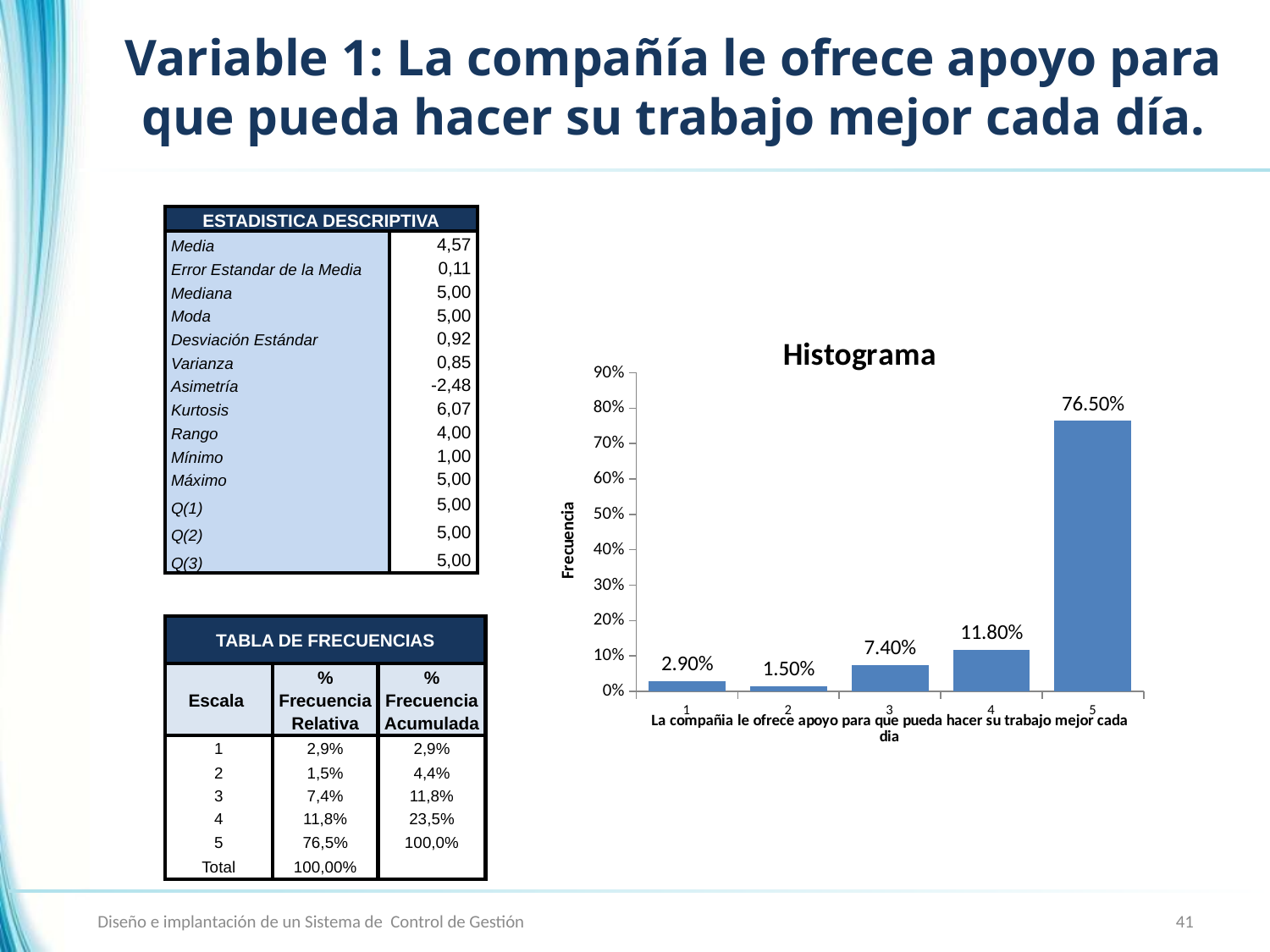
Is the value for category 5 in the Histograma chart greater or less than 70%? greater What is the difference between the values for category 4 and category 3 in the Histograma chart? 4.40% What is the value for category 5 in the Histograma chart? 76.50% Do the values in the Histograma chart rise or fall from category 2 to category 5? rise Which category has the highest value in the Histograma chart? 5 What is the y-axis label of the Histograma chart? Frecuencia What kind of chart is the Histograma? bar chart Which is larger in the Histograma chart, the value for category 1 or category 2? 1 What is the value for category 3 in the Histograma chart? 7.40% What is the value for category 1 in the Histograma chart? 2.90% How many categories are shown on the x axis of the Histograma chart? 5 Which category has the lowest value in the Histograma chart? 2